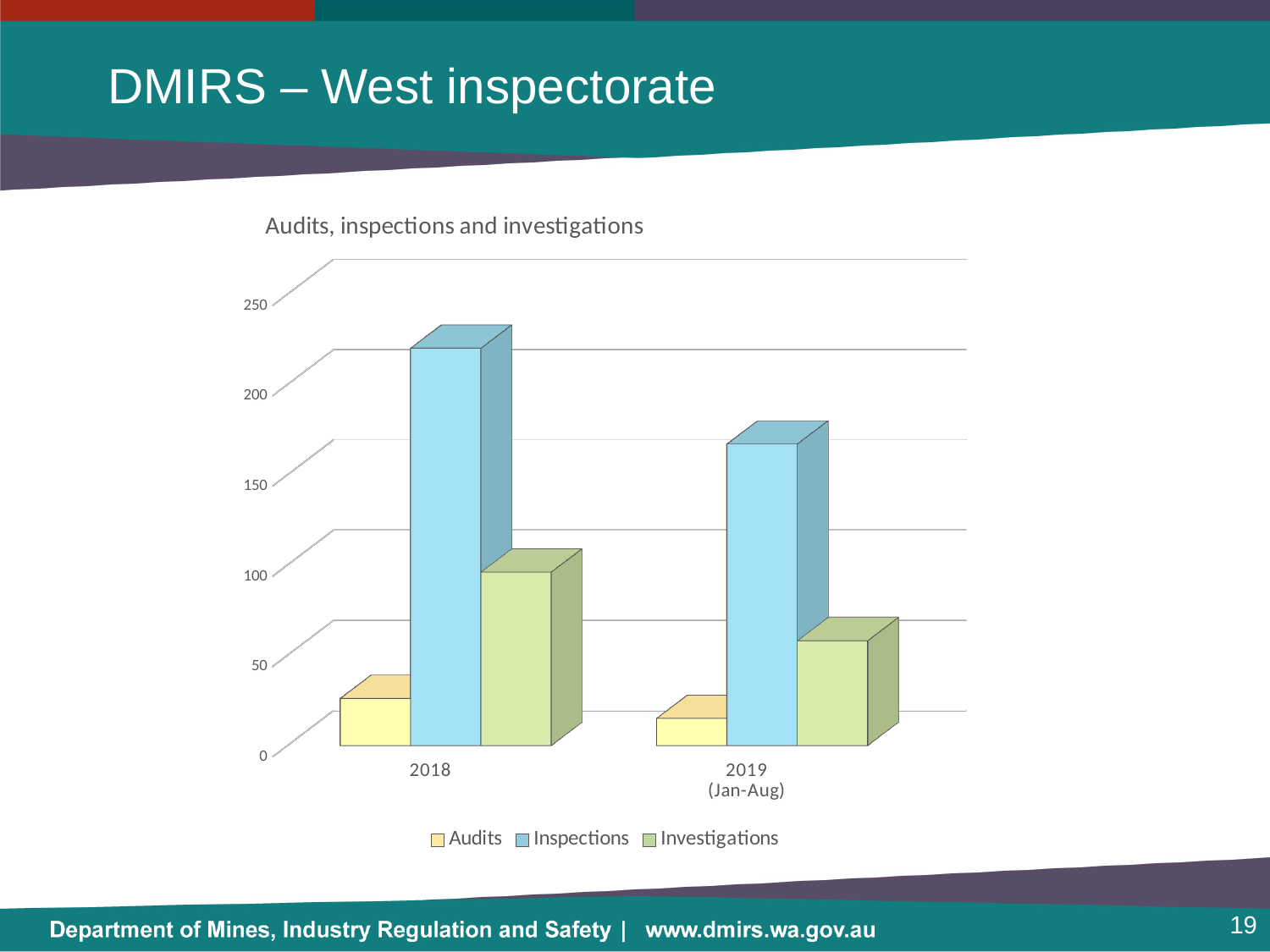
Which is larger: Inspections in 2018 or Inspections in 2019 (Jan-Aug)? Inspections in 2018 Is the value for Inspections in 2019 (Jan-Aug) greater or less than 150? greater How many series does the legend list? 3 How many categories are shown on the x axis? 2 Which series has the lowest value in 2019 (Jan-Aug)? Audits What is the title of the chart? Audits, inspections and investigations Is the value for Investigations in 2019 (Jan-Aug) greater or less than 100? less Which series has the highest value in 2018? Inspections Do the Investigations values rise or fall from 2018 to 2019 (Jan-Aug)? fall What kind of chart is shown on the slide? bar chart Is the value for Inspections in 2018 greater or less than 200? greater